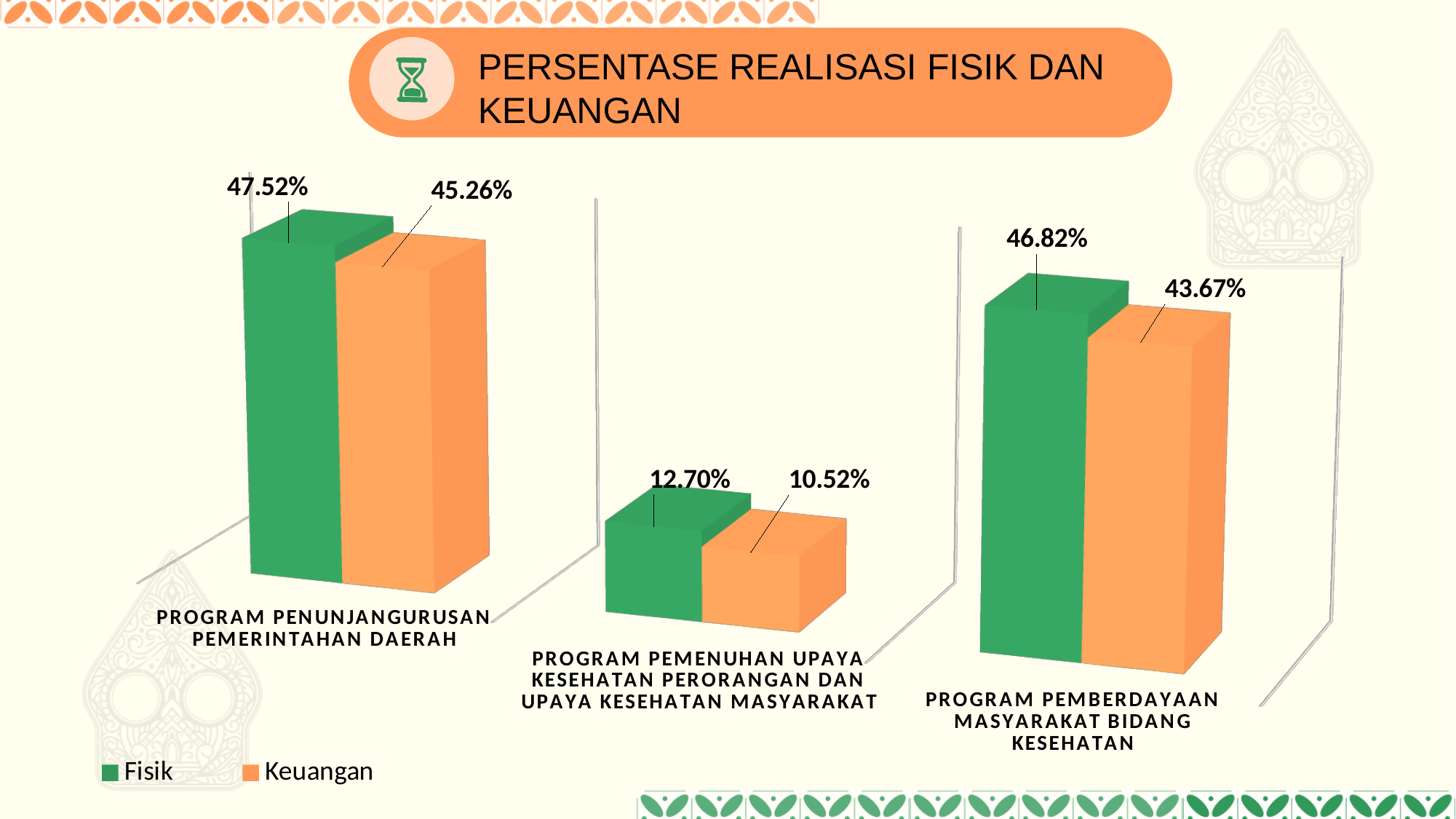
How many series does the legend list? 2 What is the Fisik value for Program Pemberdayaan Masyarakat Bidang Kesehatan? 46.82% What type of chart is shown on the slide? Bar chart What is the difference between the Fisik and Keuangan values for Program Penunjang Urusan Pemerintahan Daerah? 2.26% What is the Fisik value for Program Penunjang Urusan Pemerintahan Daerah? 47.52% What is the Keuangan value for Program Pemenuhan Upaya Kesehatan Perorangan dan Upaya Kesehatan Masyarakat? 10.52% Which is larger for Program Pemenuhan Upaya Kesehatan Perorangan dan Upaya Kesehatan Masyarakat, the Fisik value or the Keuangan value? Fisik Which program has the highest Keuangan value? Program Penunjang Urusan Pemerintahan Daerah What is the difference between the Fisik and Keuangan values for Program Pemberdayaan Masyarakat Bidang Kesehatan? 3.15% How many programs are shown on the chart? 3 Which program has the lowest Fisik value? Program Pemenuhan Upaya Kesehatan Perorangan dan Upaya Kesehatan Masyarakat What is the Keuangan value for Program Pemberdayaan Masyarakat Bidang Kesehatan? 43.67%